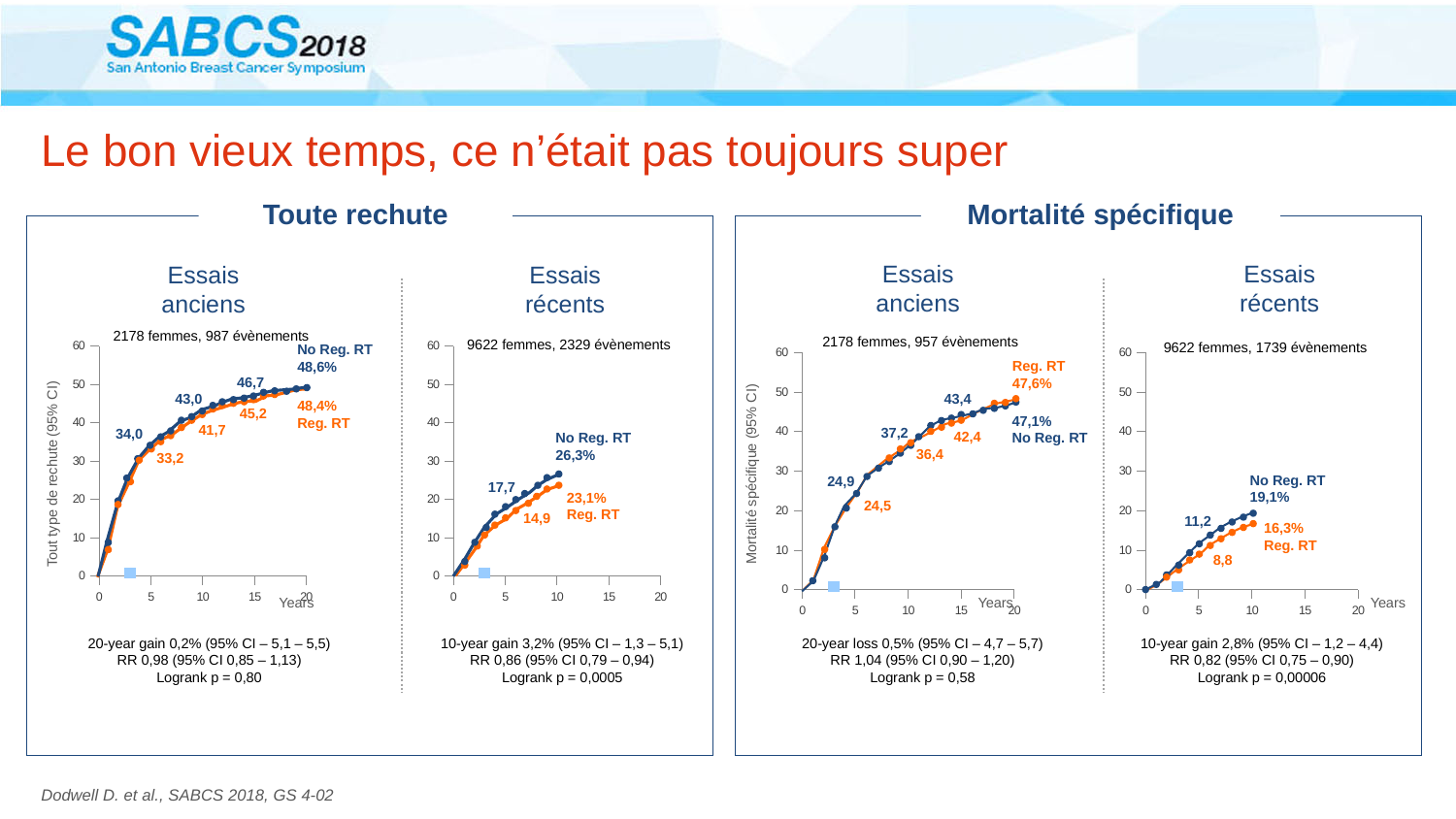
In the 'Mortalité spécifique' / 'Essais récents' chart, what is the difference between the final No Reg. RT value (19,1%) and the final Reg. RT value (16,3%)? 2,8% In the 'Mortalité spécifique' / 'Essais anciens' chart, what is the final value shown for Reg. RT? 47,6% In the 'Toute rechute' / 'Essais anciens' chart, what is the final value shown for No Reg. RT? 48,6% In the 'Toute rechute' / 'Essais récents' chart, what is the final value shown for Reg. RT? 23,1% In the 'Toute rechute' / 'Essais récents' chart, which series has the higher final value, No Reg. RT or Reg. RT? No Reg. RT In the 'Toute rechute' / 'Essais récents' chart, what is the final value shown for No Reg. RT? 26,3% In the 'Toute rechute' / 'Essais anciens' chart, what is the final value shown for Reg. RT? 48,4% How many series are plotted in the 'Mortalité spécifique' / 'Essais récents' chart? 2 What kind of chart is the 'Toute rechute' / 'Essais anciens' chart? Line chart In the 'Mortalité spécifique' / 'Essais anciens' chart, is the final value for Reg. RT greater or less than 40? greater How many women and events are stated above the 'Mortalité spécifique' / 'Essais récents' chart? 9622 femmes, 1739 évènements In the 'Mortalité spécifique' / 'Essais récents' chart, what is the final value shown for No Reg. RT? 19,1%